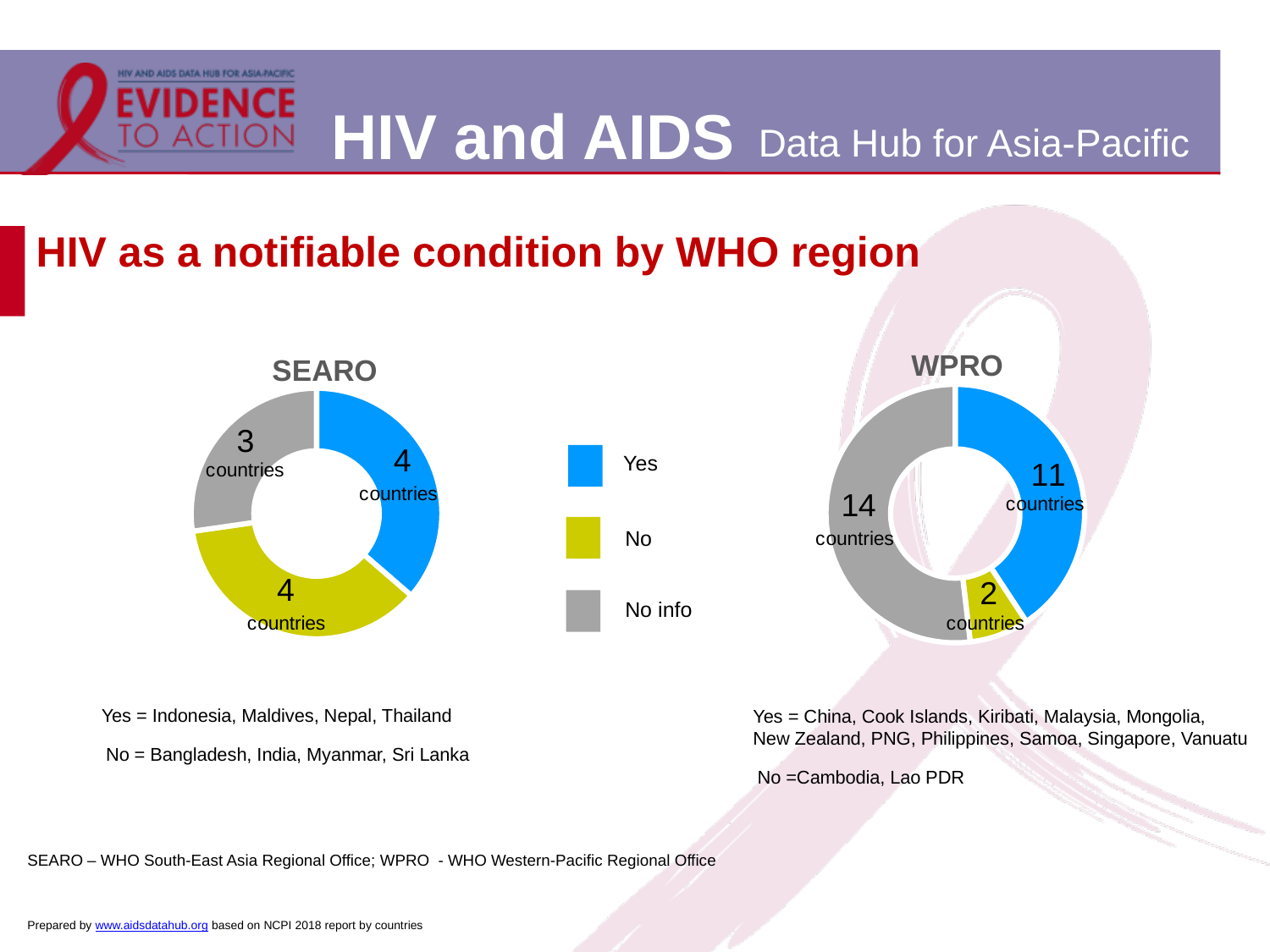
In the SEARO chart, which category has the fewest countries? No info In the SEARO chart, how many countries are in the 'No info' category? 3 countries What is the total number of countries shown in the WPRO chart? 27 What type of chart is used for SEARO and WPRO? Doughnut chart How many categories does the legend list? 3 In the WPRO chart, which category has the fewest countries? No In the WPRO chart, which category has the most countries? No info In the WPRO chart, how many countries are in the 'No' category? 2 countries In the WPRO chart, what is the difference between the number of 'No info' countries and 'Yes' countries? 3 In the WPRO chart, how many countries are in the 'Yes' category? 11 countries In the SEARO chart, how many countries are in the 'Yes' category? 4 countries Which chart has more 'Yes' countries, SEARO or WPRO? WPRO